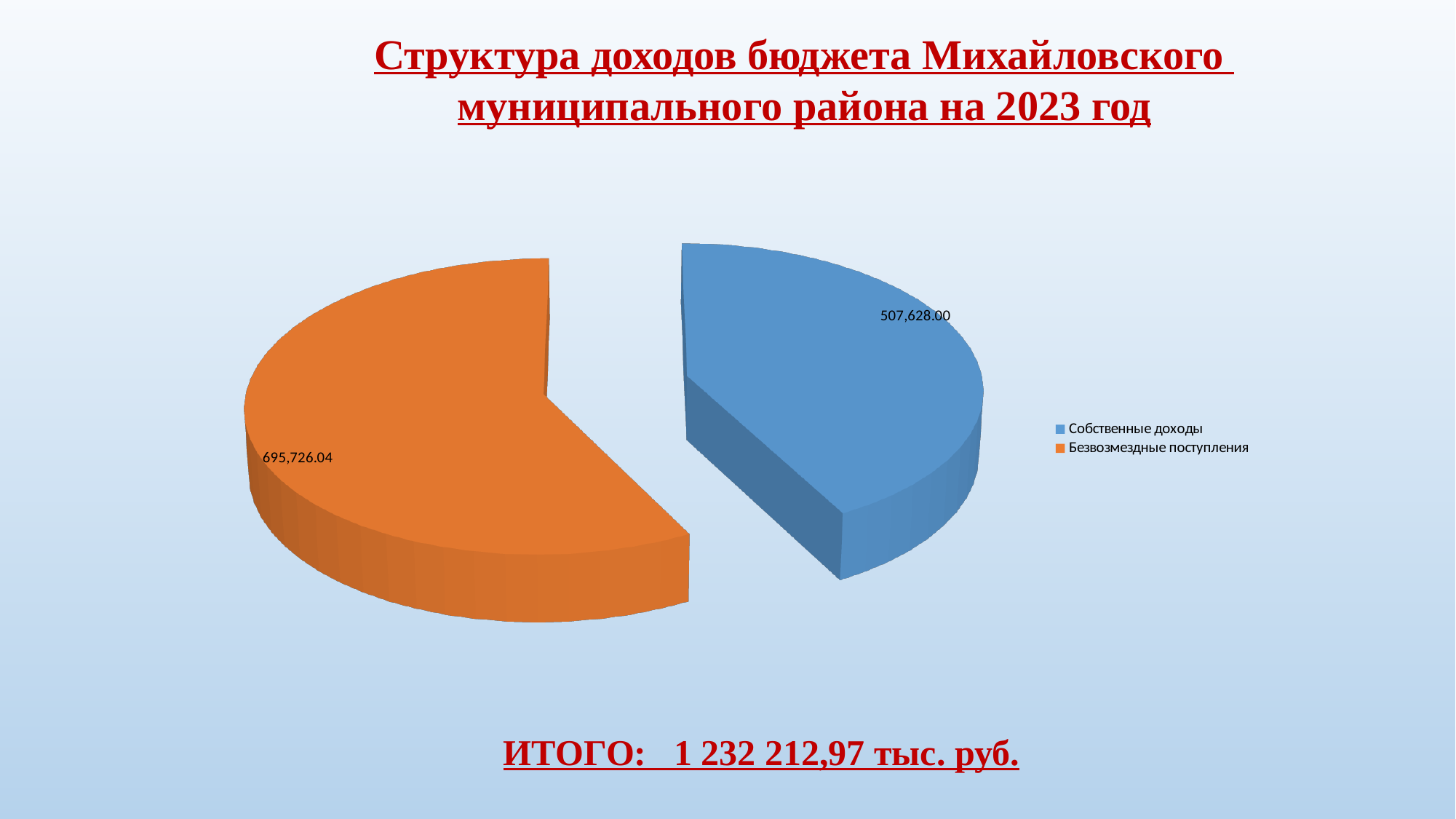
Which is larger, Собственные доходы or Безвозмездные поступления? Безвозмездные поступления What total (ИТОГО) is printed below the chart? 1 232 212,97 тыс. руб. What is the difference between the Безвозмездные поступления value and the Собственные доходы value? 188,098.04 How many slices does the pie chart have? 2 What colour is the Безвозмездные поступления slice? Orange Which category has the smallest slice of the pie? Собственные доходы How many entries does the legend list? 2 Which category has the largest slice of the pie? Безвозмездные поступления What kind of chart is shown on the slide? Pie chart What is the value of the Безвозмездные поступления slice? 695,726.04 What is the value of the Собственные доходы slice? 507,628.00